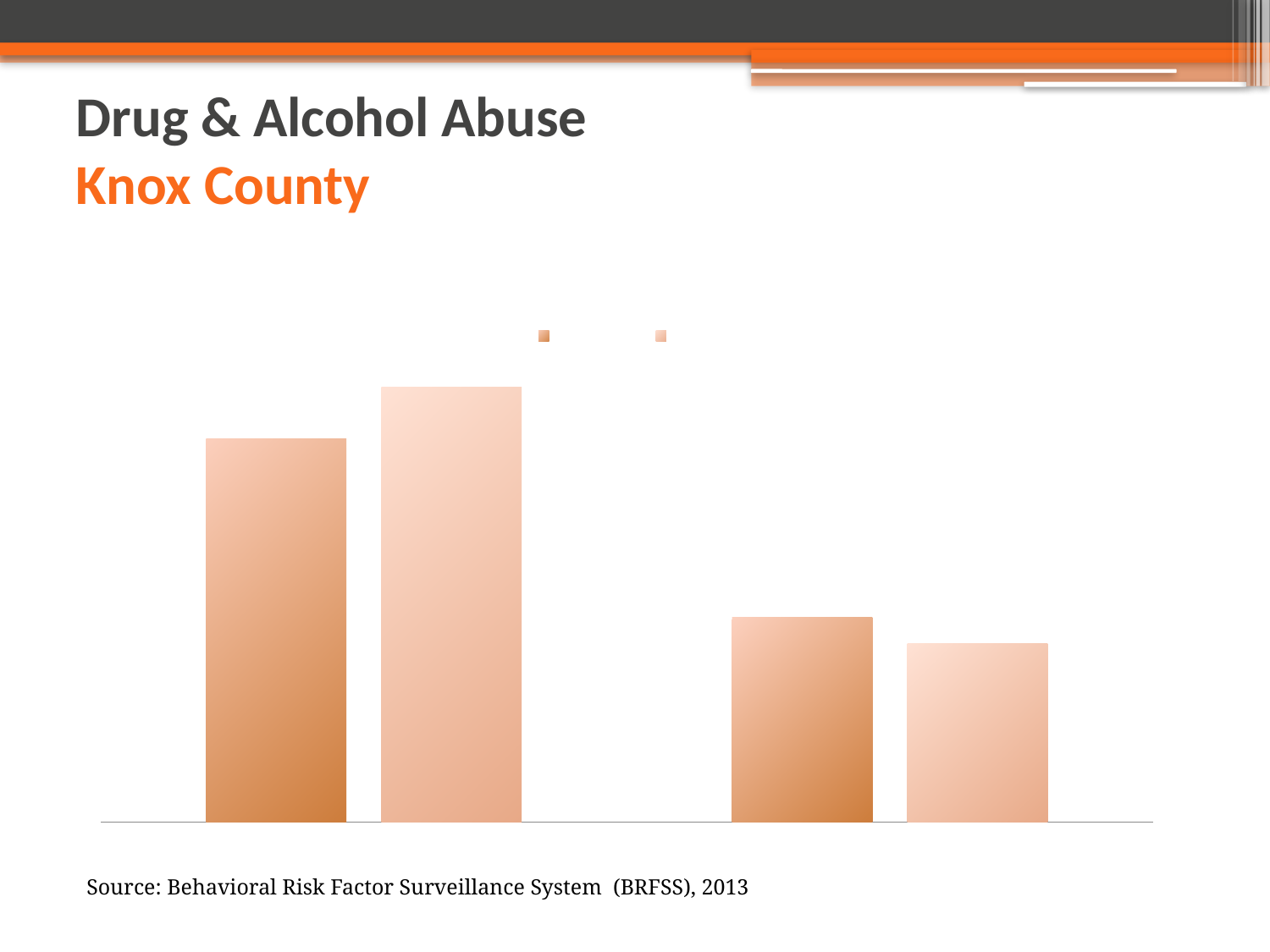
How many series does the chart's legend list? 2 Which bar is the shortest in the chart: the first, second, third or fourth from the left? fourth Which bar is the tallest in the chart: the first, second, third or fourth from the left? second Is the leftmost bar taller or shorter than the rightmost bar? taller What kind of chart is shown on the slide? bar chart How many bars are plotted in the chart? 4 What data source is cited below the chart? Behavioral Risk Factor Surveillance System (BRFSS), 2013 Is the second bar from the left taller or shorter than the third bar from the left? taller Which county is named in the slide title above the chart? Knox County